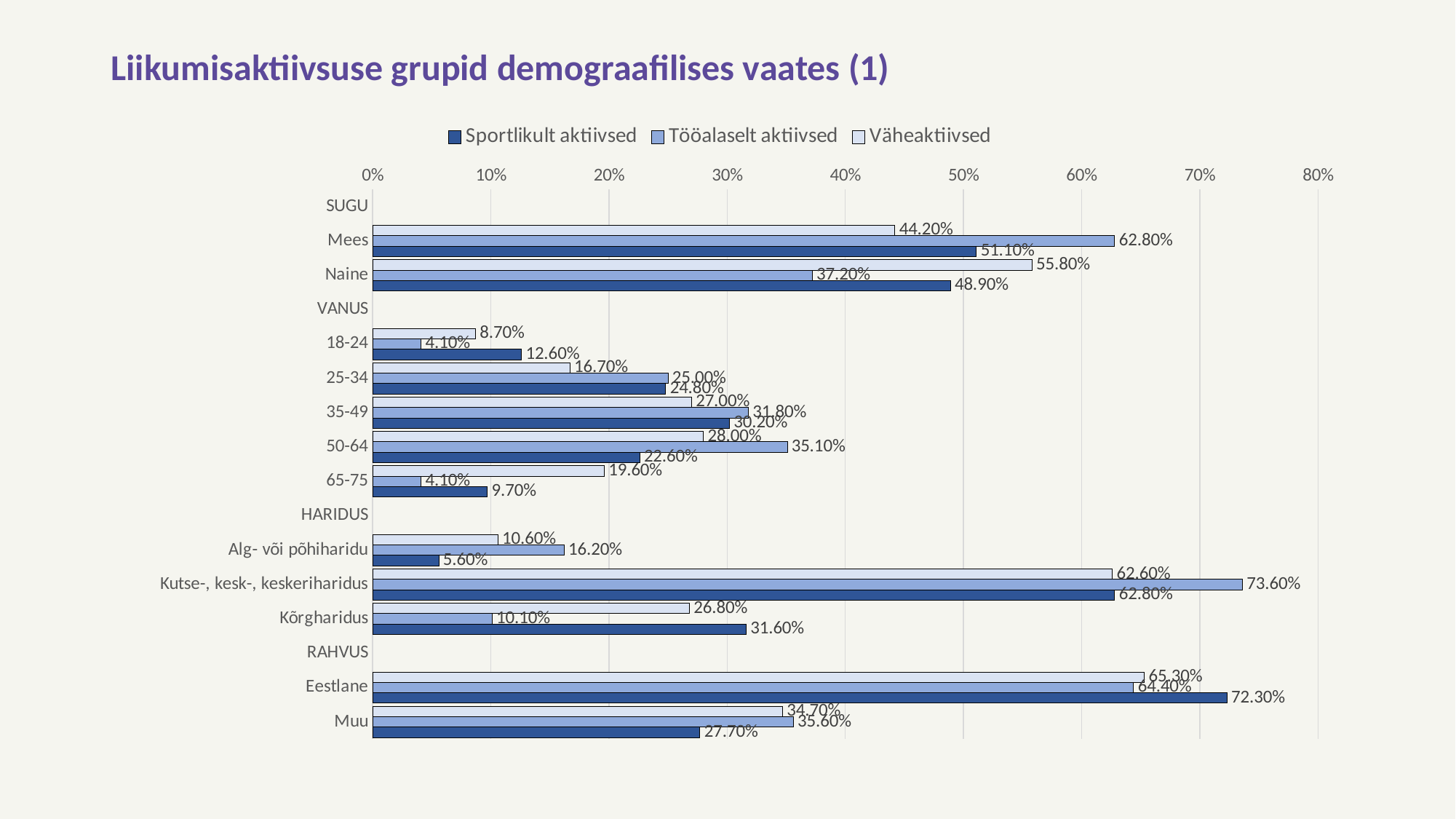
What kind of chart is shown on the slide? Bar chart Which is larger for 50-64: the Tööalaselt aktiivsed value or the Väheaktiivsed value? Tööalaselt aktiivsed How many series does the legend list? 3 Which series is shown in the darkest blue colour? Sportlikult aktiivsed Which category has the highest Tööalaselt aktiivsed value? Kutse-, kesk-, keskeriharidus What is the Väheaktiivsed value for 65-75? 19.60% What is the title of the slide? Liikumisaktiivsuse grupid demograafilises vaates (1) What is the Tööalaselt aktiivsed value for Naine? 37.20% What is the difference between the Sportlikult aktiivsed values for Eestlane and Muu? 44.60% Which category has the lowest Sportlikult aktiivsed value? Alg- või põhiharidu What is the Sportlikult aktiivsed value for Mees? 51.10% What is the Sportlikult aktiivsed value for Kõrgharidus? 31.60%